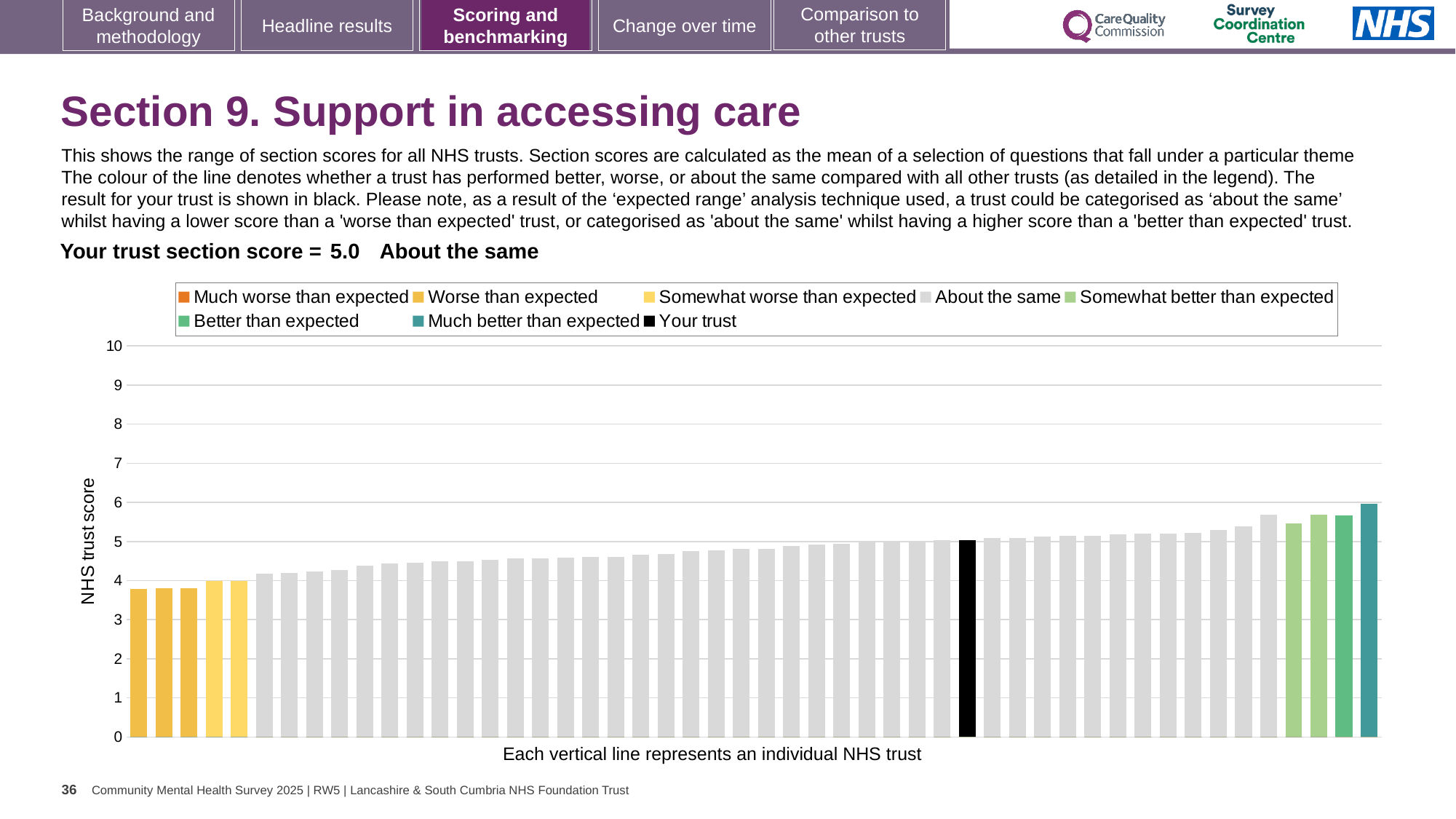
What is the label of the vertical axis? NHS trust score What kind of chart is shown on the slide? bar chart How many entries does the chart legend list? 8 Is the value of the highest bar greater or less than 5? greater How many bars are coloured as 'Much better than expected'? 1 Is the value of the rightmost bar greater or less than 4? greater Do the bar values rise or fall from left to right along the x axis? rise Is the value of the leftmost bar greater or less than 5? less How many bars are coloured as 'Worse than expected'? 3 What is the section score for your trust shown on the slide? 5.0 Which legend category is shown in black? Your trust